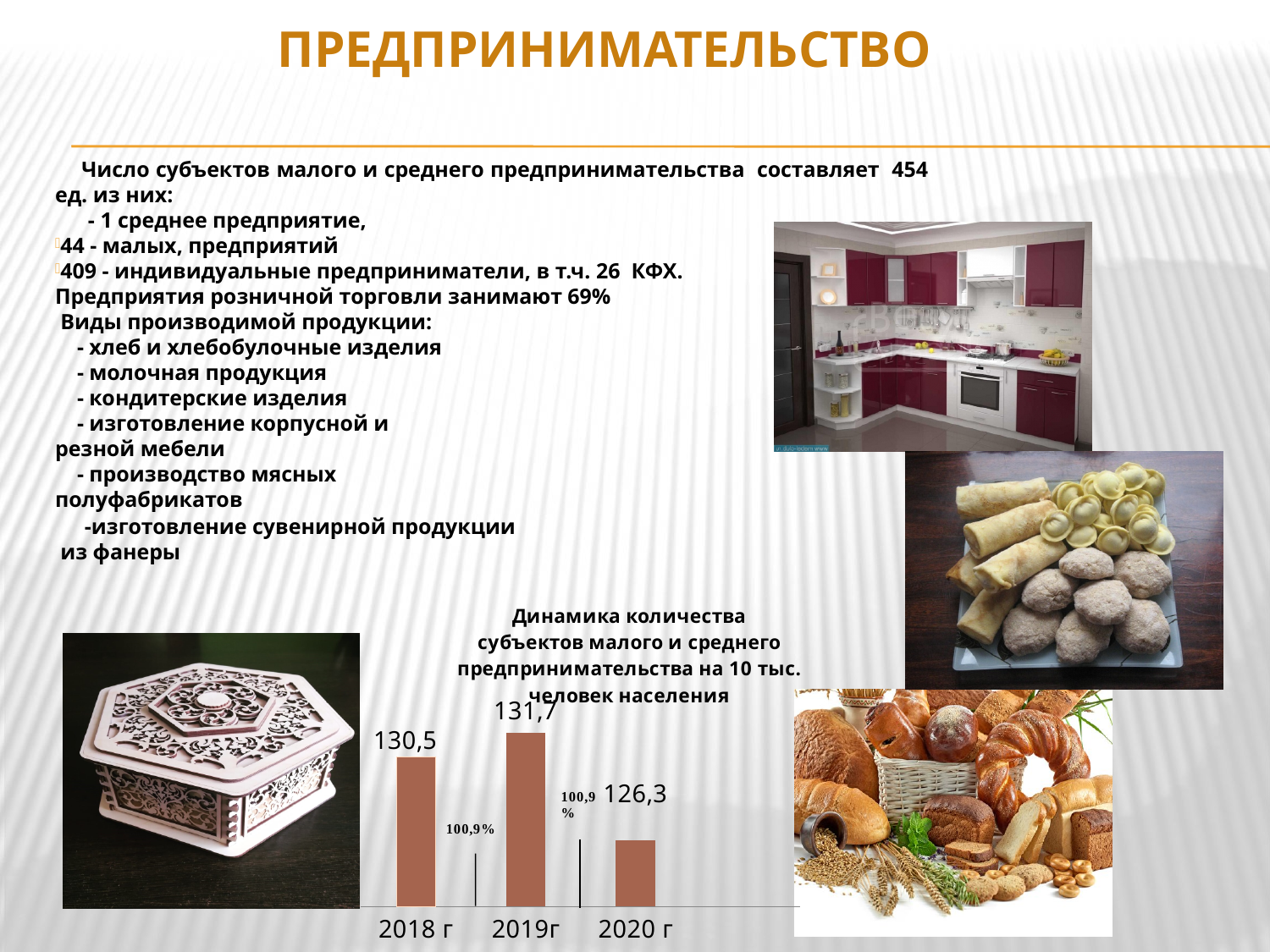
Which year has the lowest value in the chart? 2020 г What type of chart is shown on the slide? bar chart What is the value for 2019г in the chart? 131,7 Does the value fall or rise from 2019г to 2020 г? fall What is the title of the chart? Динамика количества субъектов малого и среднего предпринимательства на 10 тыс. человек населения Which year has the highest value in the chart? 2019г What is the value for 2018 г in the chart? 130,5 What is the difference between the values for 2018 г and 2020 г? 4,2 What is the value for 2020 г in the chart? 126,3 Which is larger, the value for 2018 г or the value for 2020 г? 2018 г What is the difference between the values for 2019г and 2020 г? 5,4 How many years are shown in the chart? 3